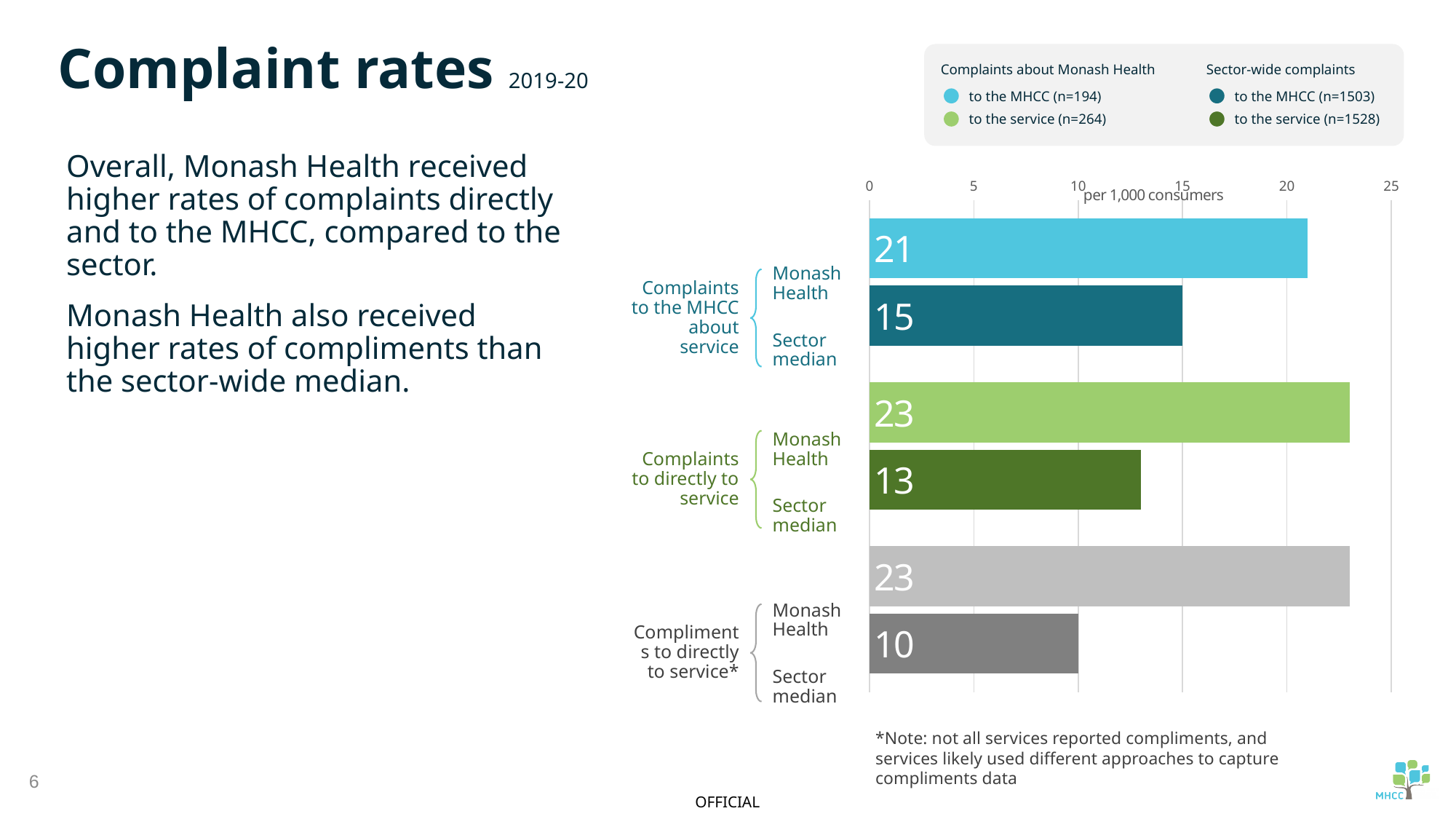
What is the difference between Monash Health and the sector median for complaints directly to service? 10 According to the legend, how many complaints about Monash Health were made to the MHCC? n=194 What is the sector median rate of complaints to the MHCC about service? 15 What unit is the horizontal axis of the chart measured in? per 1,000 consumers What kind of chart is shown on the slide? Bar chart What is the rate of complaints to the MHCC about service for Monash Health? 21 What is the sector median rate of compliments directly to service? 10 What is the rate of complaints directly to service for Monash Health? 23 What is the difference between Monash Health and the sector median for complaints to the MHCC about service? 6 How many bars are plotted on the chart? 6 Which bar has the lowest value on the chart? Sector median, compliments directly to service Which is larger: the sector median for complaints to the MHCC about service or the sector median for complaints directly to service? Sector median for complaints to the MHCC about service